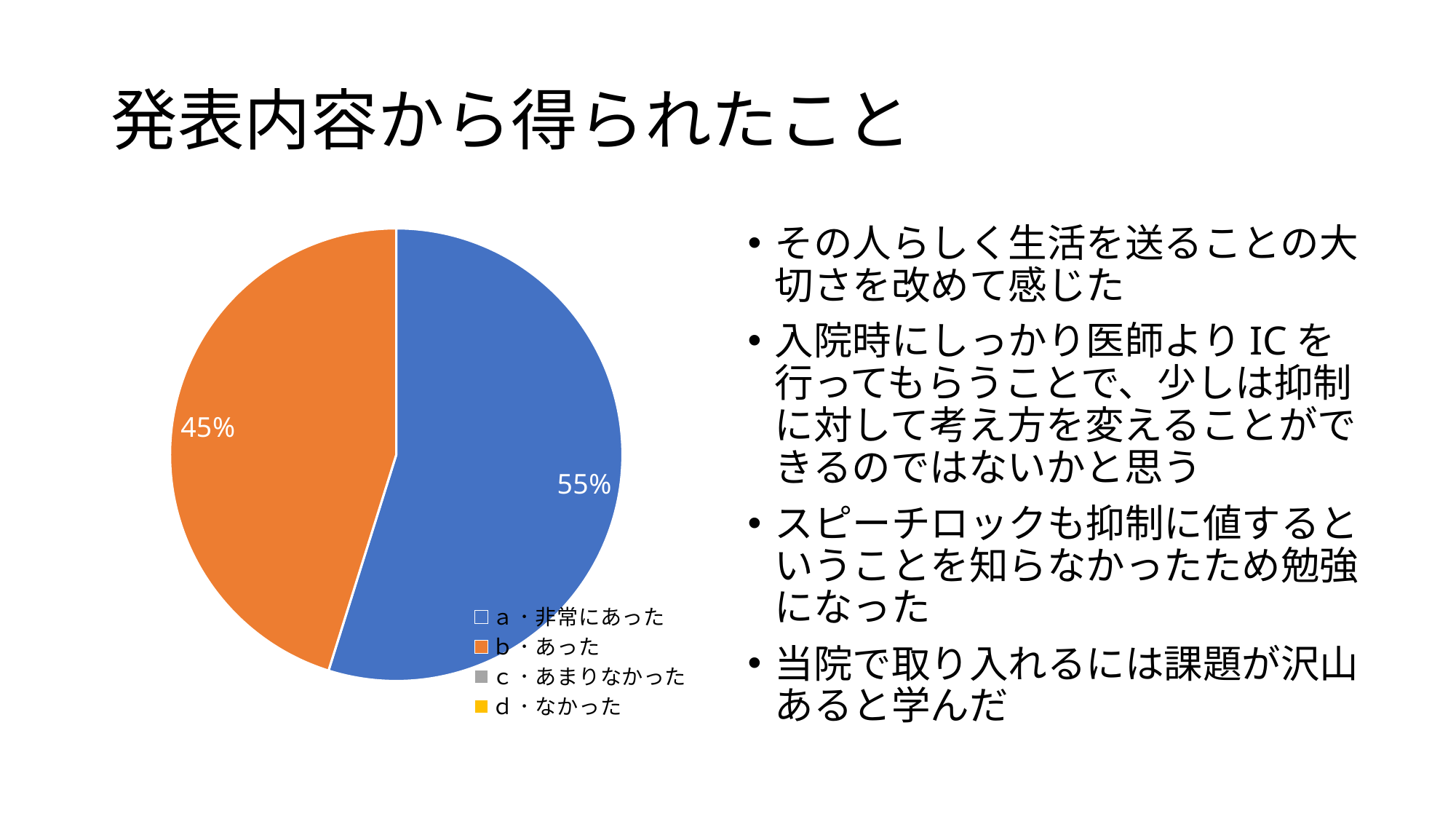
What colour is the slice for "b・あった"? orange Which category has the largest slice of the pie? a・非常にあった What share of the pie does "b・あった" take? 45% What is the difference in percentage points between the "a・非常にあった" slice and the "b・あった" slice? 10 Is the share for "b・あった" greater or less than 50%? less How many slices are visible in the pie? 2 How many entries does the legend list? 4 What colour is the slice for "a・非常にあった"? blue Which is larger, the slice for "a・非常にあった" or the slice for "b・あった"? a・非常にあった What kind of chart is shown on the slide? pie chart What share of the pie does "a・非常にあった" take? 55%